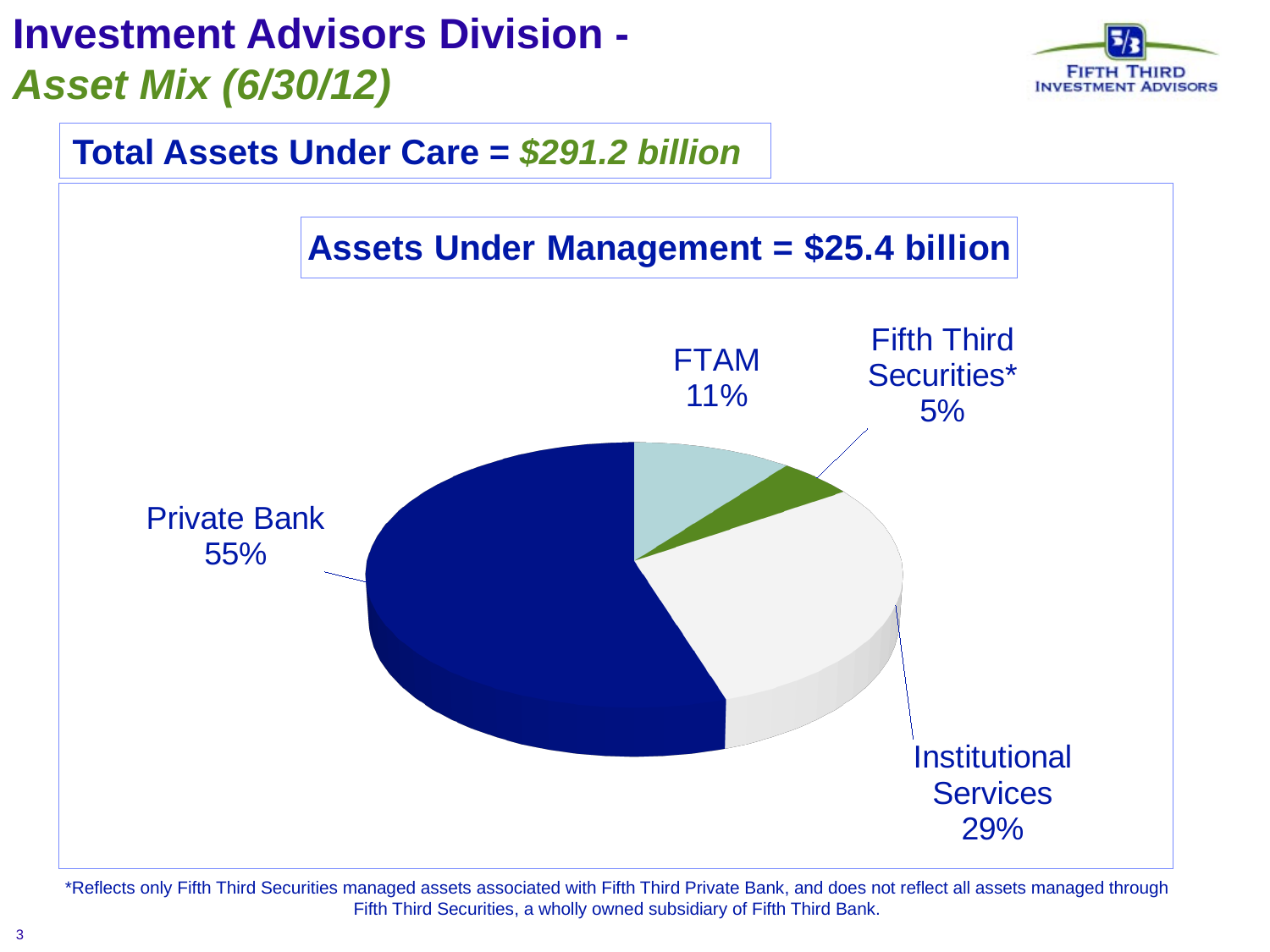
What percentage is shown for Fifth Third Securities*? 5% Which category has the largest share of the pie? Private Bank What is the difference in percentage points between Private Bank and Institutional Services? 26 What is the difference in percentage points between FTAM and Fifth Third Securities*? 6 What share does FTAM represent? 11% Which category has the smallest share of the pie? Fifth Third Securities* What kind of chart is shown on the slide? Pie chart What share of assets under management does Private Bank hold? 55% Which is larger, the share for Institutional Services or the share for FTAM? Institutional Services What total value of Assets Under Management is stated above the pie chart? $25.4 billion How many slices does the pie chart have? 4 What percentage of the pie is Institutional Services? 29%